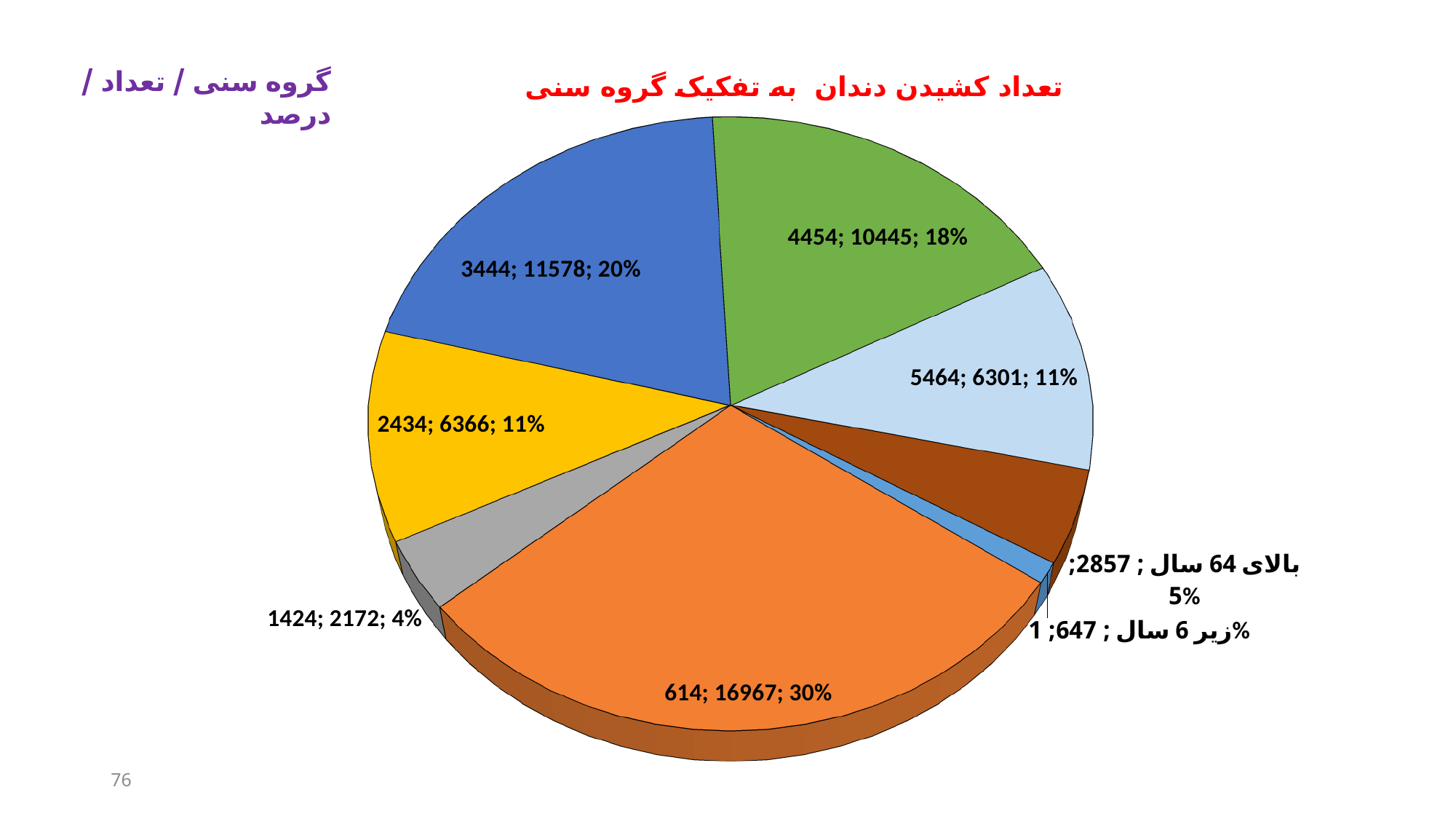
Which slice has the smallest share of the pie? زیر 6 سال What count is shown for the slice labelled بالای 64 سال? 2857 What count is shown for the slice labelled 614? 16967 What count is shown for the slice labelled 4454? 10445 Which has a larger count, the slice labelled 2434 or the slice labelled 5464? 2434 What is the title of the chart? تعداد کشیدن دندان به تفکیک گروه سنی What percentage share does the slice labelled 1424 have? 4% What kind of chart is shown on the slide? pie chart What is the difference between the counts for the slices labelled 3444 and 4454? 1133 Which slice has the largest share of the pie? 614 How many slices does the pie chart have? 8 What percentage share does the slice labelled 3444 have? 20%